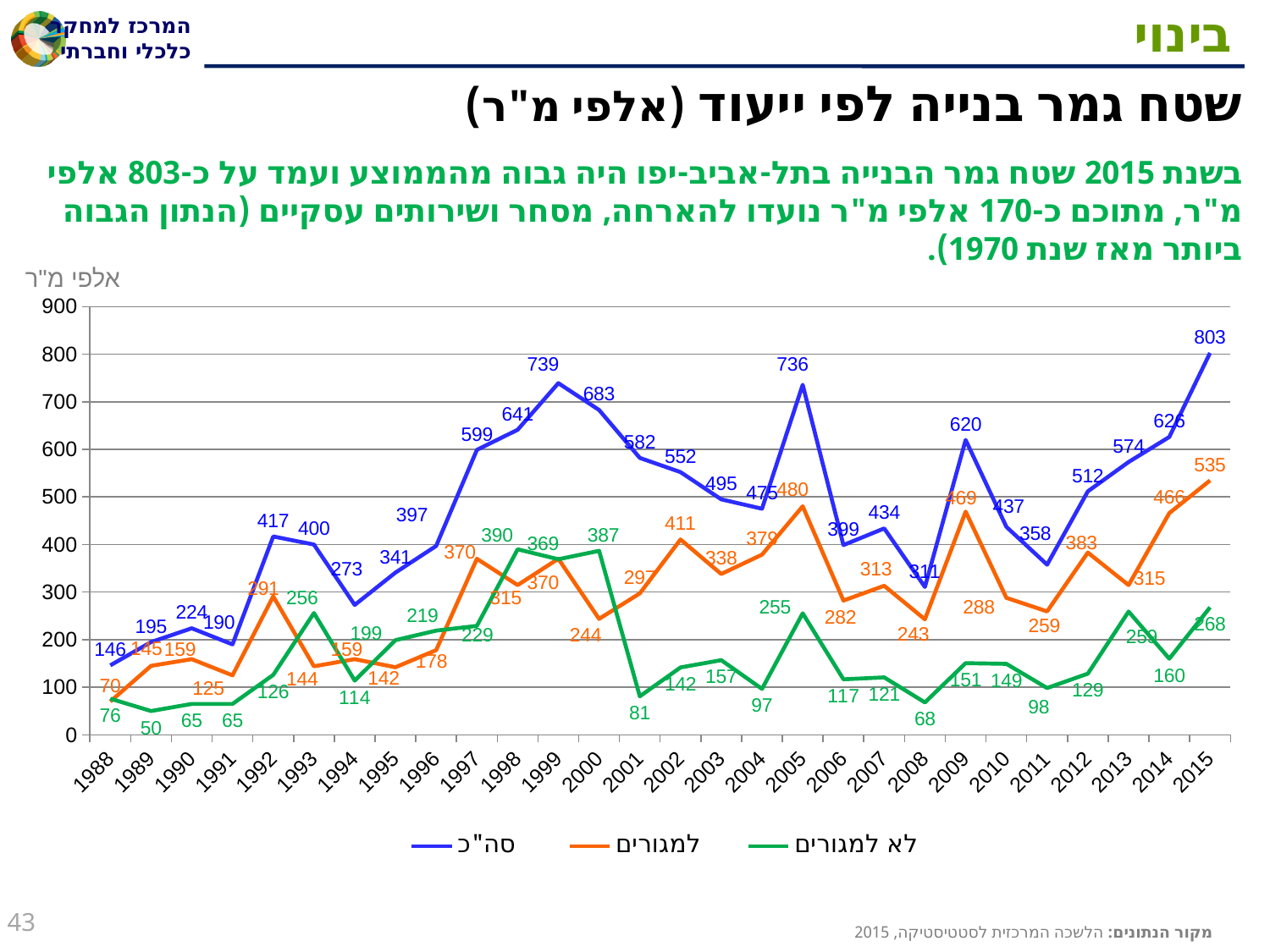
What is the difference between the למגורים value and the לא למגורים value in 2015? 267 What kind of chart is shown on the slide? line chart Which series has the larger value in 1998, למגורים or לא למגורים? לא למגורים What is the value of the למגורים series in 2005? 480 How many years are shown on the x axis? 28 In which year does the לא למגורים series have its lowest value? 1989 Does the סה"כ series rise or fall from 2011 to 2015? rise In which year does the סה"כ series reach its highest value? 2015 How many series does the legend list? 3 What is the value of the סה"כ series in 2015? 803 Is the value of the סה"כ series in 2009 greater or less than 600? greater What is the value of the לא למגורים series in 1998? 390